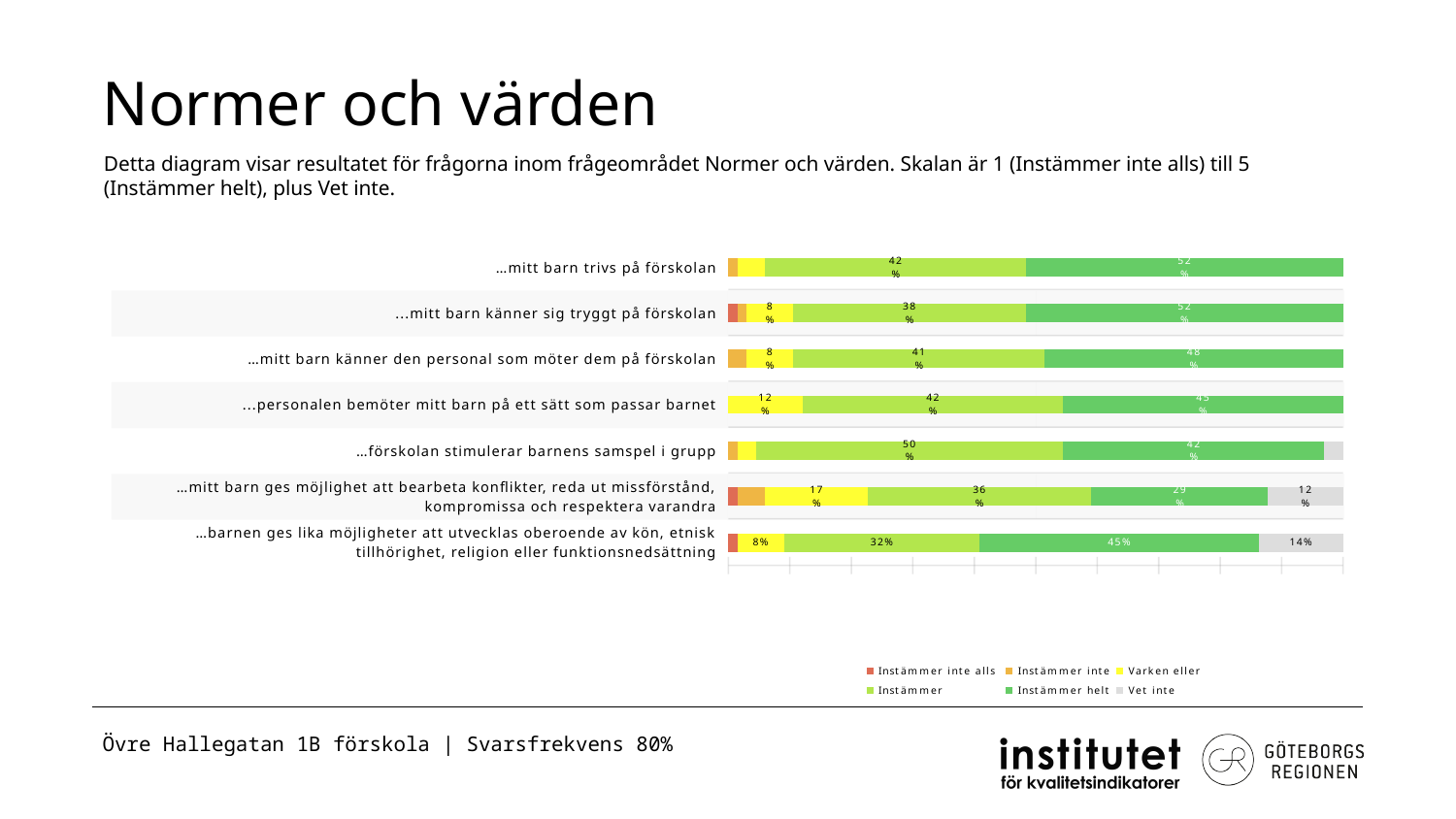
What kind of chart is shown on the slide? Stacked bar chart Which question has the highest "Instämmer" share? …förskolan stimulerar barnens samspel i grupp What is the "Vet inte" share for "…barnen ges lika möjligheter att utvecklas oberoende av kön, etnisk tillhörighet, religion eller funktionsnedsättning"? 14% What is the difference between the "Instämmer helt" values for "…mitt barn känner sig tryggt på förskolan" and "…mitt barn känner den personal som möter dem på förskolan"? 4% What percentage of respondents answered "Instämmer helt" for "…mitt barn trivs på förskolan"? 52% Which legend entry is shown in grey? Vet inte What is the "Varken eller" value for "…personalen bemöter mitt barn på ett sätt som passar barnet"? 12% How many questions (categories) are shown in the chart? 7 Which question has the lowest "Instämmer helt" share? …mitt barn ges möjlighet att bearbeta konflikter, reda ut missförstånd, kompromissa och respektera varandra Which is larger for "…mitt barn ges möjlighet att bearbeta konflikter, reda ut missförstånd, kompromissa och respektera varandra": the "Instämmer" share or the "Instämmer helt" share? Instämmer What is the "Instämmer" value for "…förskolan stimulerar barnens samspel i grupp"? 50% How many series does the legend list? 6